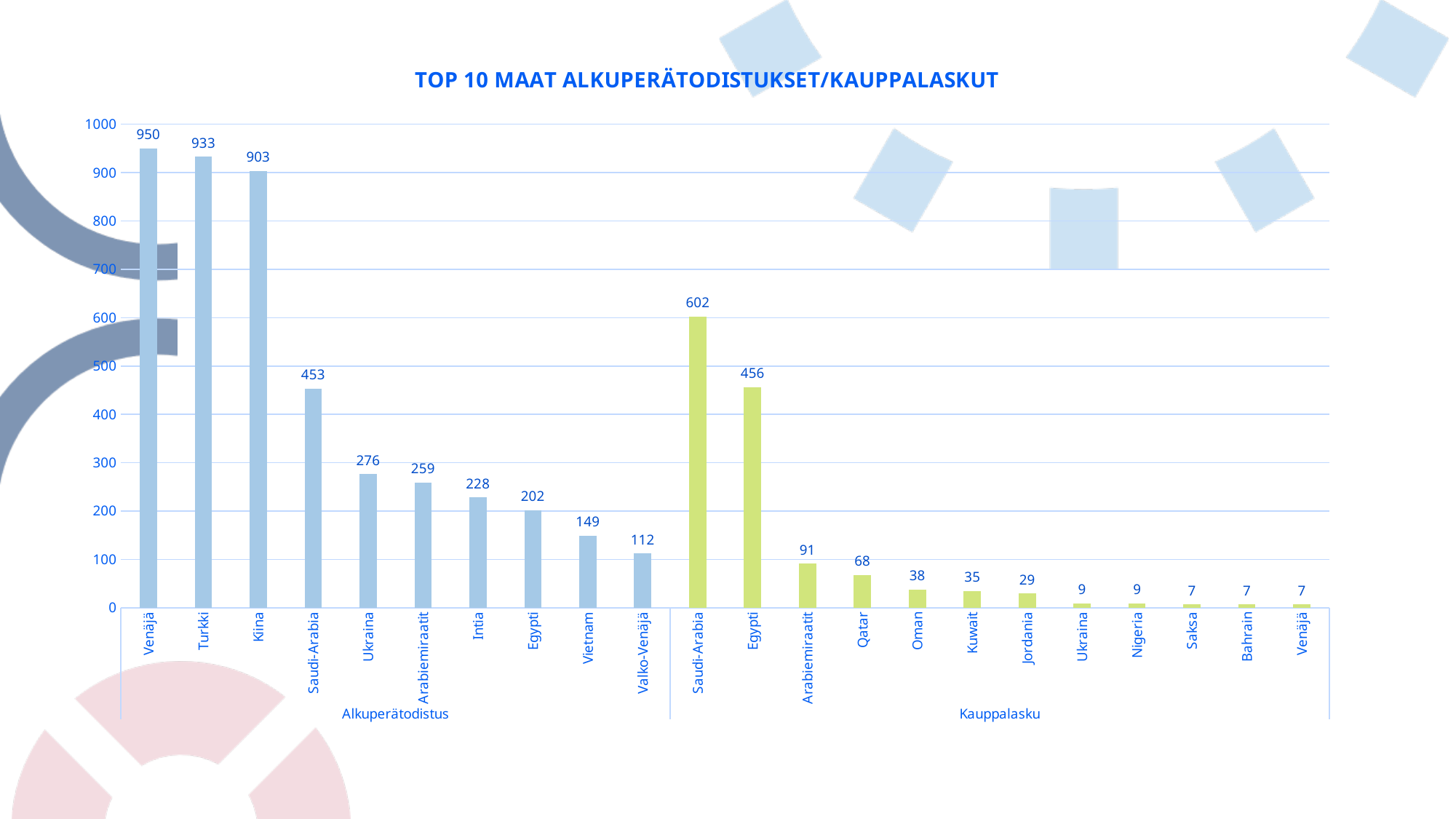
Which country has the highest value in the Kauppalasku group? Saudi-Arabia How many bars are in the Kauppalasku group? 12 What is the value for Venäjä in the Alkuperätodistus group? 950 What is the value for Saudi-Arabia in the Kauppalasku group? 602 Which is larger: the value for Ukraina in the Alkuperätodistus group or the value for Arabiemiraatit in the Alkuperätodistus group? Ukraina What is the value for Vietnam in the Alkuperätodistus group? 149 How many bars are in the Alkuperätodistus group? 10 What kind of chart is shown on the slide? Bar chart What is the difference between the values for Turkki and Kiina in the Alkuperätodistus group? 30 What is the difference between the values for Saudi-Arabia and Egypti in the Kauppalasku group? 146 Which country has the lowest value in the Alkuperätodistus group? Valko-Venäjä What is the title of the chart? TOP 10 MAAT ALKUPERÄTODISTUKSET/KAUPPALASKUT